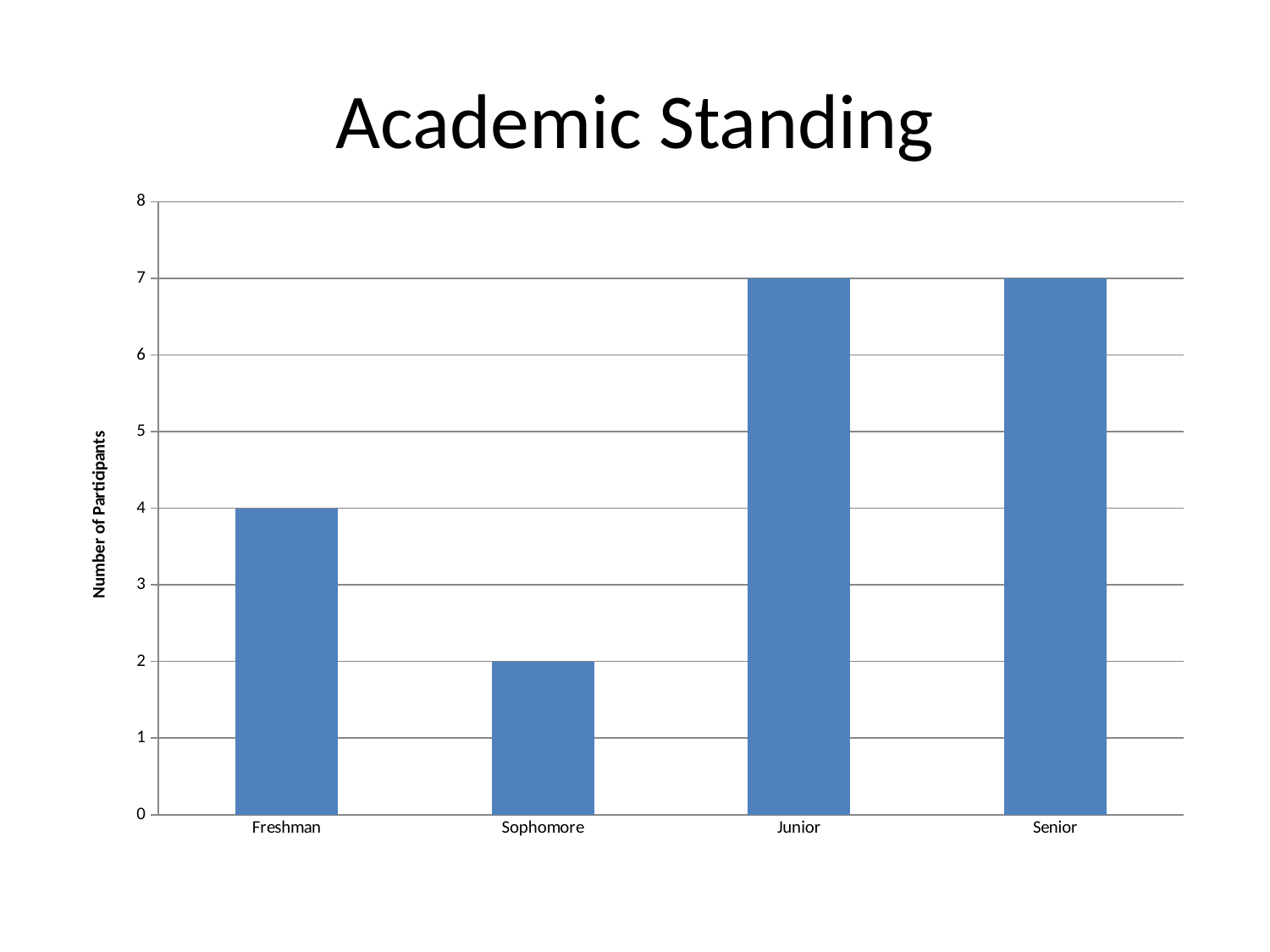
What is the number of participants for Senior? 7 Which academic standing has the lowest number of participants? Sophomore Is the value for Junior greater or less than 5? greater What kind of chart is shown on the slide? Bar chart What is the difference in number of participants between Junior and Freshman? 3 What is the number of participants for Sophomore? 2 What is the label on the vertical axis of the chart? Number of Participants What is the number of participants for Junior? 7 How many academic standing categories are shown on the chart? 4 What is the number of participants for Freshman? 4 Which has more participants, Freshman or Sophomore? Freshman What is the difference in number of participants between Freshman and Sophomore? 2